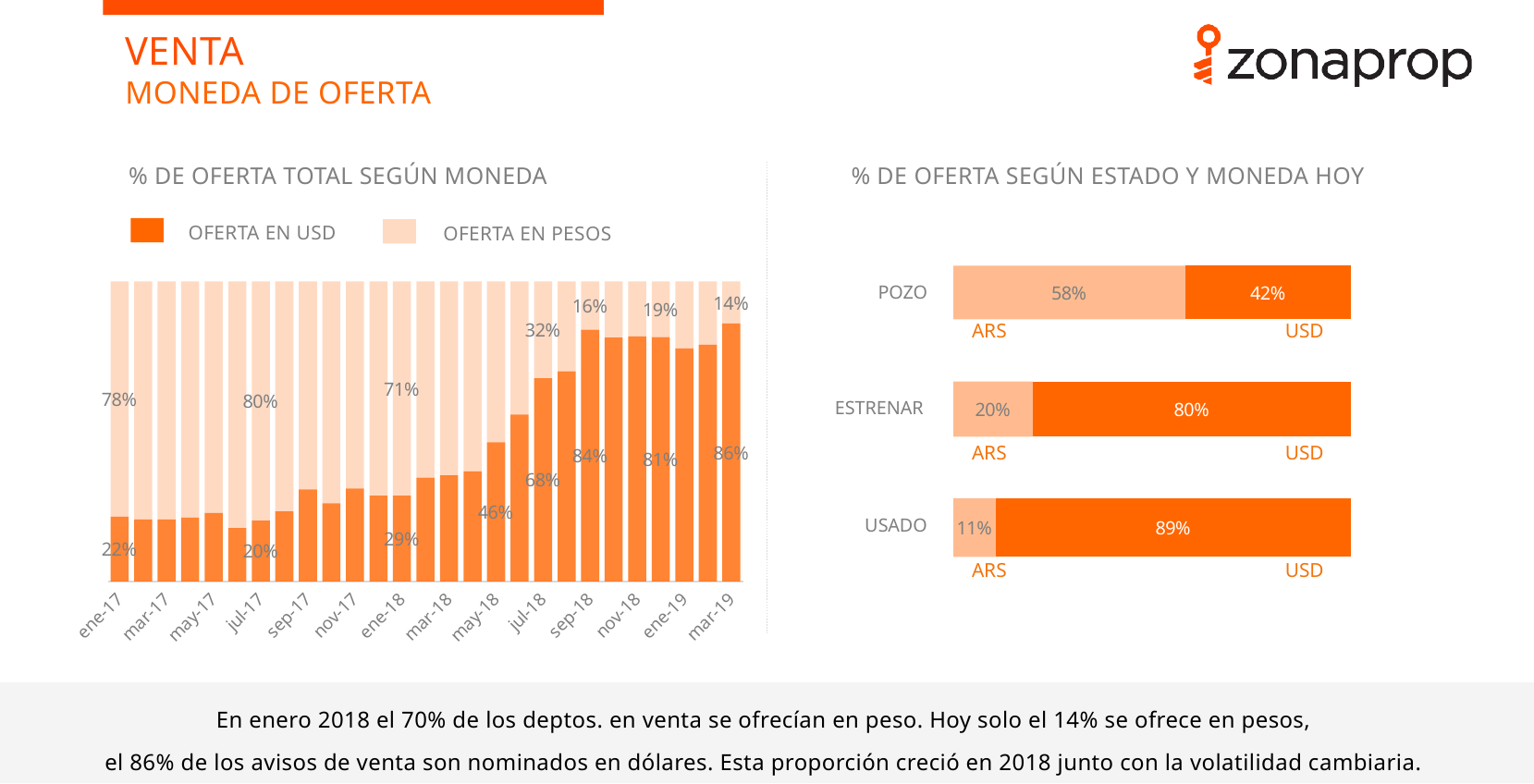
How many series does the legend of the chart '% DE OFERTA TOTAL SEGÚN MONEDA' list? 2 In the chart '% DE OFERTA TOTAL SEGÚN MONEDA', does the OFERTA EN USD share rise or fall from ene-17 to mar-19? Rises In the chart '% DE OFERTA TOTAL SEGÚN MONEDA', what is the OFERTA EN PESOS share for ene-17? 78% In the chart '% DE OFERTA SEGÚN ESTADO Y MONEDA HOY', what is the USD share for USADO? 89% In the chart '% DE OFERTA SEGÚN ESTADO Y MONEDA HOY', how many percentage points higher is the USD share for ESTRENAR than for POZO? 38 percentage points In the chart '% DE OFERTA SEGÚN ESTADO Y MONEDA HOY', which estado has the highest ARS share? POZO In the chart '% DE OFERTA SEGÚN ESTADO Y MONEDA HOY', which estado has the lowest USD share? POZO In the chart '% DE OFERTA SEGÚN ESTADO Y MONEDA HOY', what is the ARS share for POZO? 58% In the chart '% DE OFERTA SEGÚN ESTADO Y MONEDA HOY', what is the total of the ARS and USD segments for ESTRENAR? 100% In the chart '% DE OFERTA SEGÚN ESTADO Y MONEDA HOY', how many estado categories are shown? 3 In the chart '% DE OFERTA TOTAL SEGÚN MONEDA', what is the OFERTA EN USD share for mar-19? 86% What kind of chart is '% DE OFERTA TOTAL SEGÚN MONEDA'? Stacked bar chart